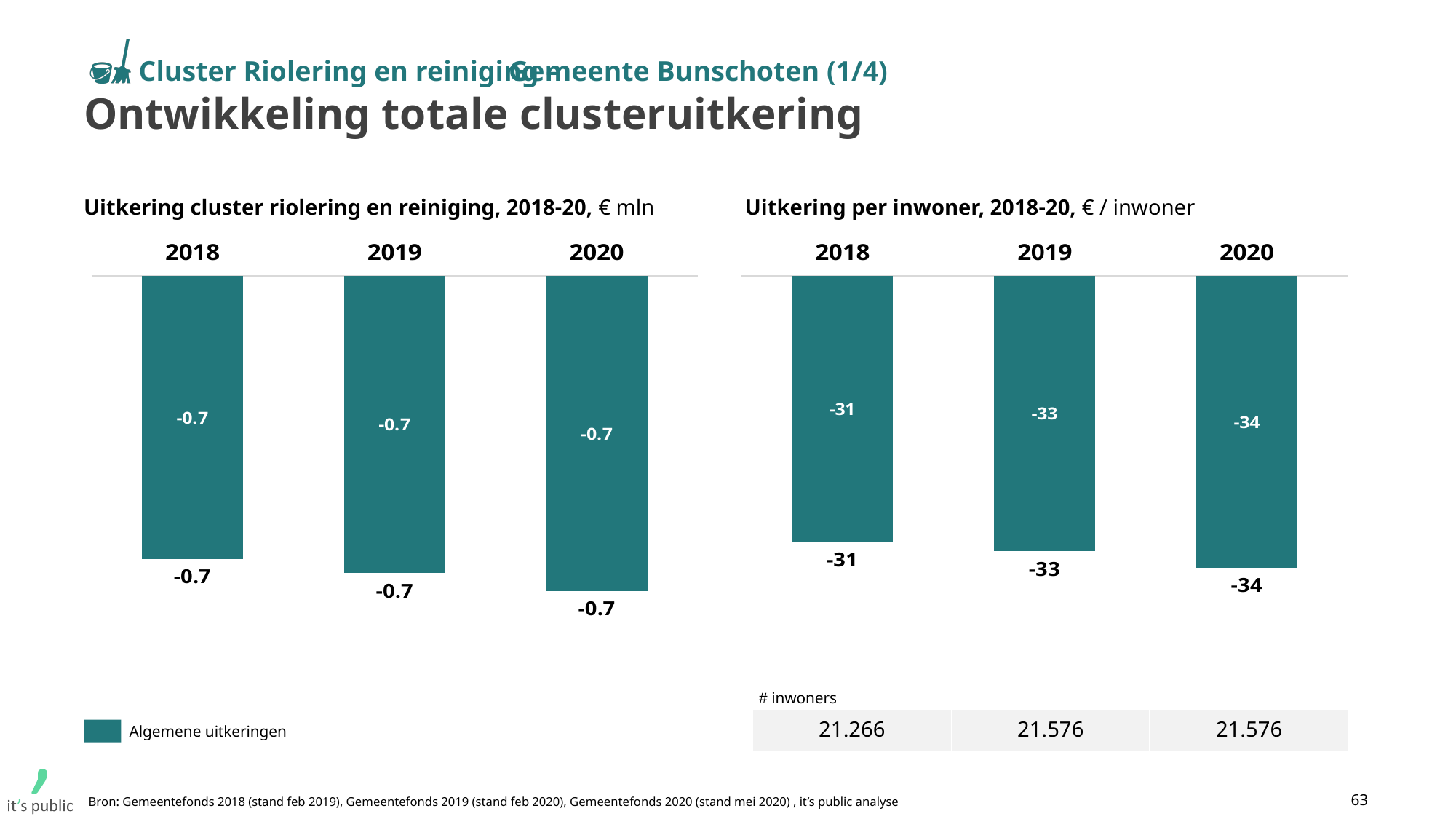
What kind of chart is 'Uitkering per inwoner, 2018-20'? bar chart How many series does the legend on the slide list? 1 How many years are shown in the chart 'Uitkering cluster riolering en reiniging, 2018-20'? 3 In the chart 'Uitkering per inwoner, 2018-20', do the values rise or fall from 2018 to 2020? fall What is the legend entry shown on the slide? Algemene uitkeringen In the chart 'Uitkering per inwoner, 2018-20', which year has the highest value? 2018 In the chart 'Uitkering per inwoner, 2018-20', what is the difference between the 2018 and 2020 values? 3 In the chart 'Uitkering per inwoner, 2018-20', what is the value for 2020? -34 In the chart 'Uitkering per inwoner, 2018-20', what is the value for 2018? -31 In the chart 'Uitkering per inwoner, 2018-20', which year has the lowest value? 2020 In the chart 'Uitkering per inwoner, 2018-20', is the value for 2019 larger or smaller than the value for 2020? larger In the chart 'Uitkering cluster riolering en reiniging, 2018-20', what is the value for 2019? -0.7